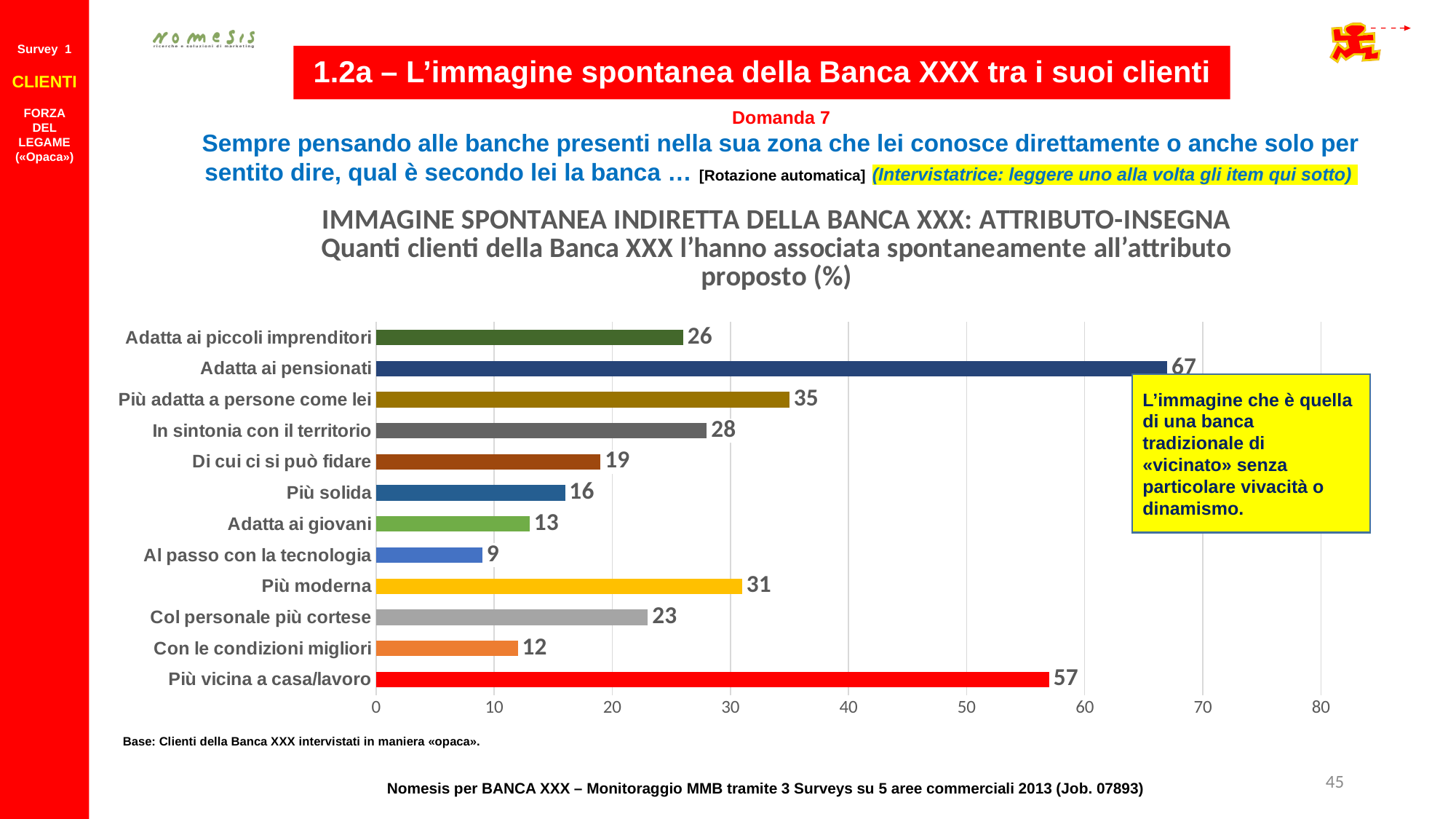
What value is shown for "Più moderna"? 31 Which category has the lowest value? Al passo con la tecnologia Which is larger, the value for "Più adatta a persone come lei" or the value for "In sintonia con il territorio"? Più adatta a persone come lei What value is shown for "Adatta ai pensionati"? 67 What colour is the bar for "Più vicina a casa/lavoro"? red How many categories are shown in the chart? 12 What kind of chart is shown on the slide? bar chart What is the difference between the values for "Adatta ai pensionati" and "Più vicina a casa/lavoro"? 10 What value is shown for "Al passo con la tecnologia"? 9 Is the value for "Col personale più cortese" greater or less than 20? greater What is the difference between the values for "Più solida" and "Adatta ai giovani"? 3 Which category has the highest value? Adatta ai pensionati